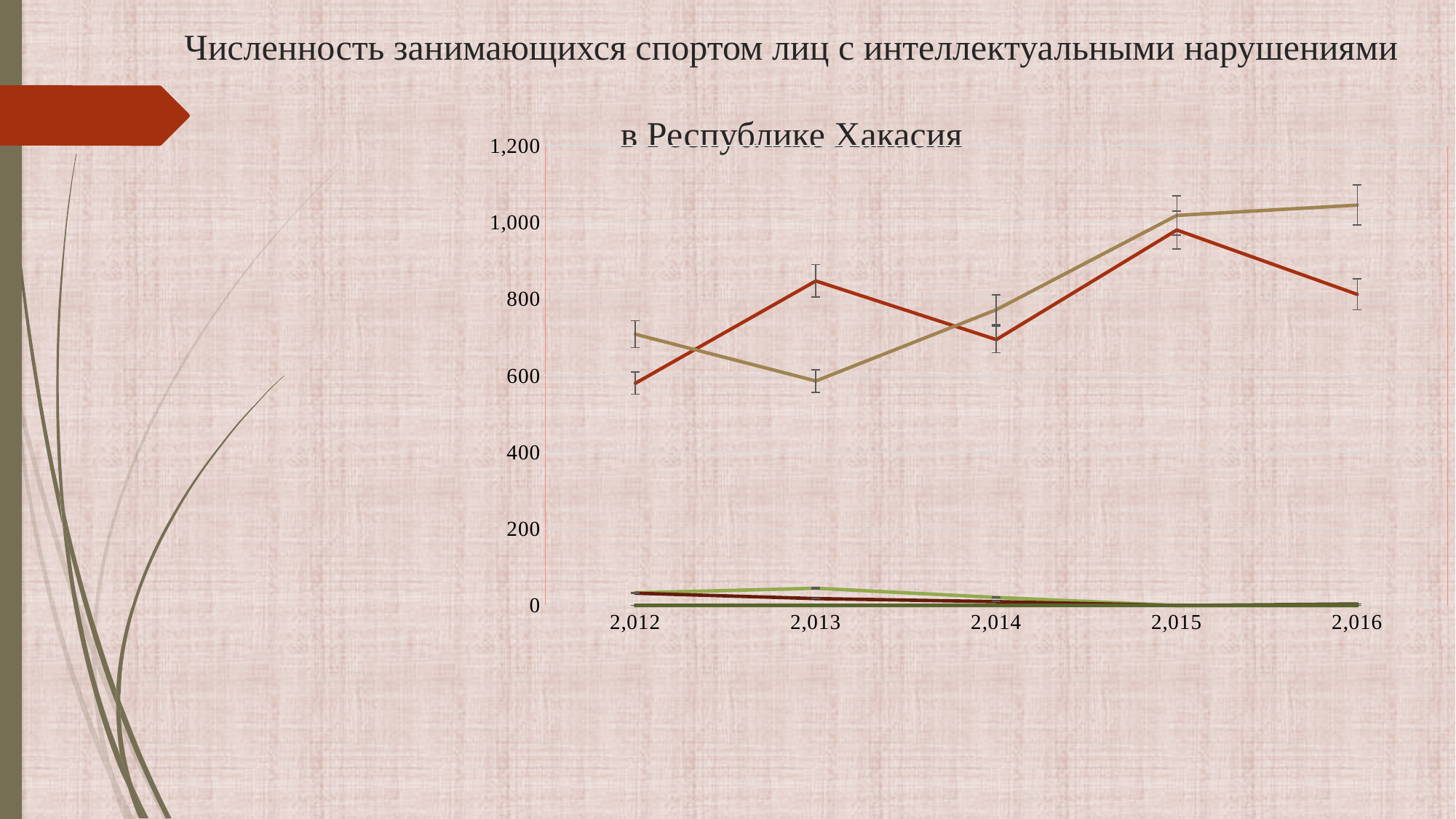
In which year does the tan line have its lowest value? 2,013 Does the tan line rise or fall from 2,013 to 2,016? rise What kind of chart is shown on the slide? line chart Is the value of the tan line in 2,016 greater or less than 1,000? greater Is the value of the red line in 2,013 greater or less than 800? greater Is the value of the red line in 2,014 greater or less than 800? less How many years are shown on the x axis of the chart? 5 In which year does the red line reach its highest value? 2,015 What is the title of the chart on the slide? Численность занимающихся спортом лиц с интеллектуальными нарушениями в Республике Хакасия In which year does the red line have its lowest value? 2,012 In 2,013, which line is higher, the red line or the tan line? the red line